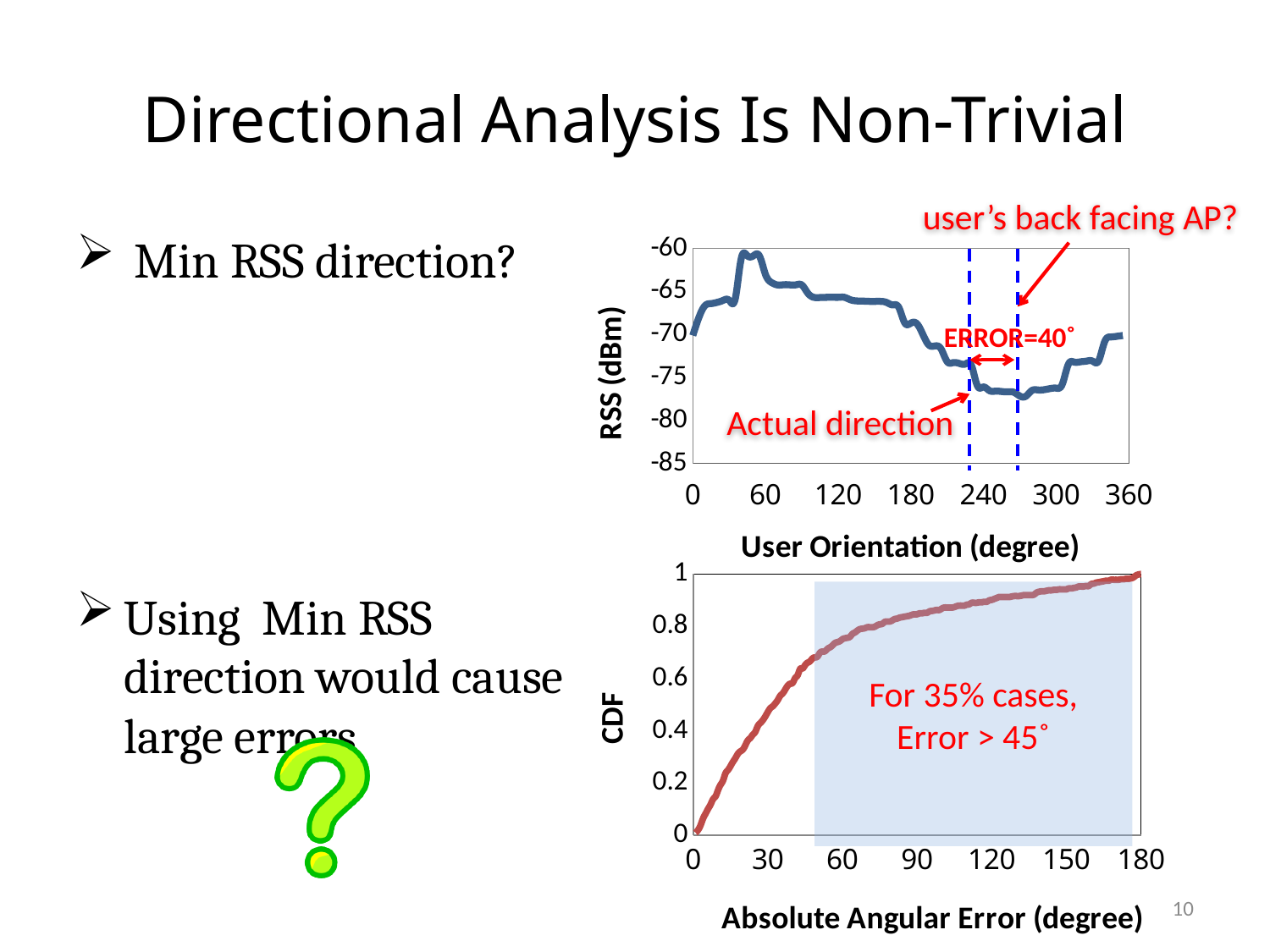
In the top chart, what error value is annotated between the actual direction and the minimum RSS direction? ERROR=40˚ In the bottom chart, is the CDF value at an absolute angular error of 30 degrees greater or less than 0.4? greater In the top chart, does the RSS rise or fall as user orientation goes from 60 to 240 degrees? fall In the top chart, what is the label of the y axis? RSS (dBm) In the bottom chart, is the CDF value at an absolute angular error of 120 degrees greater or less than 0.8? greater In the bottom chart, does the CDF rise or fall as absolute angular error increases from 0 to 180 degrees? rise In the top chart, is the RSS value at a user orientation of 180 degrees greater or less than -65 dBm? less What kind of chart is the top chart (RSS vs User Orientation)? line chart In the bottom chart, what is the label of the x axis? Absolute Angular Error (degree) What kind of chart is the bottom chart (CDF vs Absolute Angular Error)? line chart According to the annotation on the bottom chart, for what percentage of cases is the error greater than 45 degrees? 35%